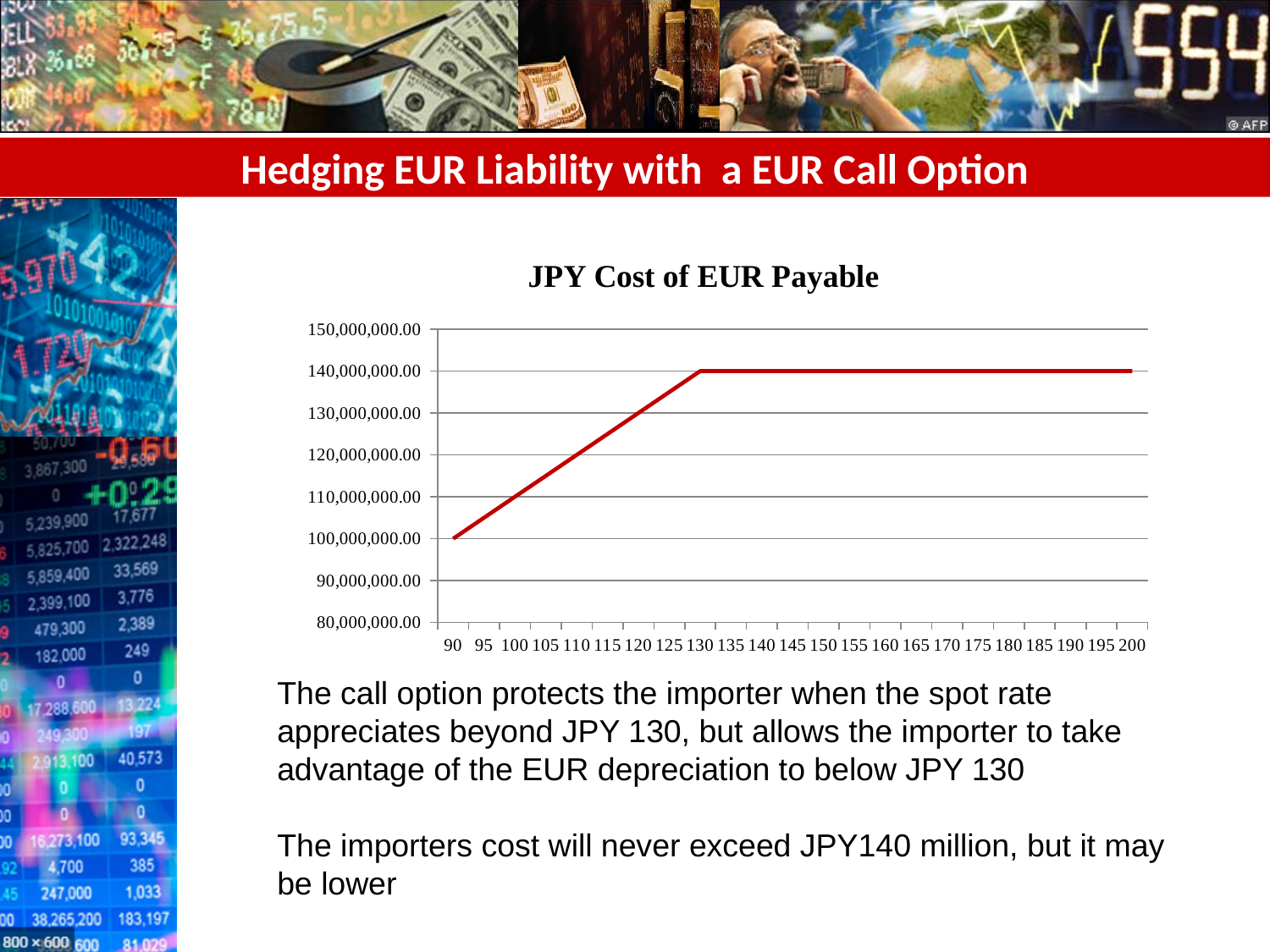
Is the JPY cost at a spot rate of 100 greater or less than 120,000,000.00? less How many spot rate values are labelled on the x axis? 23 Which spot rate has a higher JPY cost, 90 or 120? 120 What is the JPY cost of the EUR payable when the spot rate is 130? 140,000,000.00 What is the JPY cost of the EUR payable when the spot rate is 200? 140,000,000.00 Is the JPY cost at a spot rate of 160 greater or less than 130,000,000.00? greater What is the title of the chart? JPY Cost of EUR Payable What is the JPY cost of the EUR payable when the spot rate is 90? 100,000,000.00 What is the JPY cost of the EUR payable when the spot rate is 110? 120,000,000.00 What is the difference in JPY cost between a spot rate of 130 and a spot rate of 90? 40,000,000.00 What kind of chart is shown on the slide? line chart How does the JPY cost change as the spot rate rises from 90 to 130? it rises